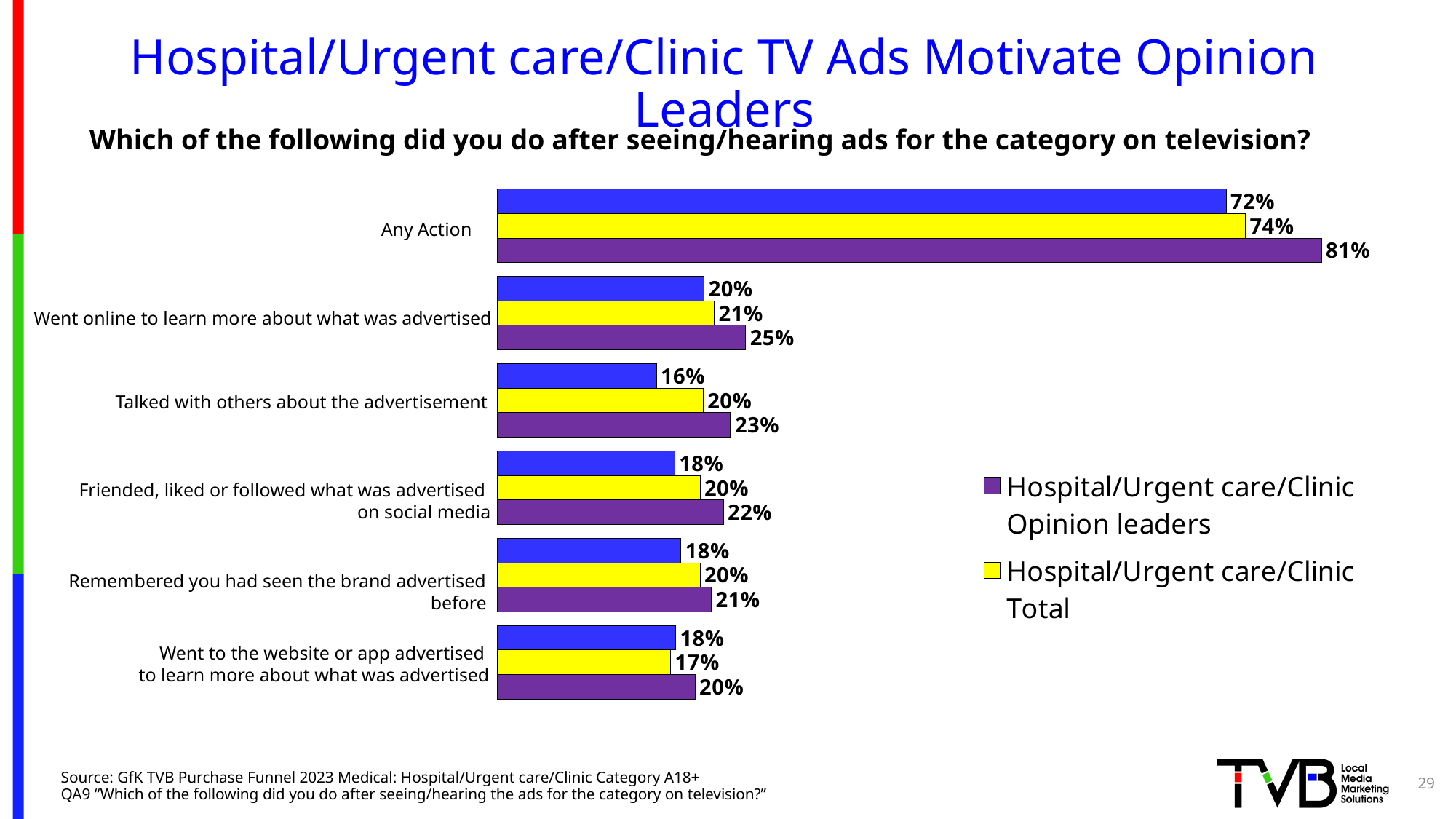
What percentage of Hospital/Urgent care/Clinic Opinion leaders talked with others about the advertisement? 23% What is the Hospital/Urgent care/Clinic Total value for 'Went to the website or app advertised to learn more about what was advertised'? 17% What colour represents Hospital/Urgent care/Clinic Total in the chart? Yellow What percentage of Hospital/Urgent care/Clinic Opinion leaders took Any Action after seeing/hearing ads on television? 81% How many action categories are shown on the chart? 6 What type of chart is shown on the slide? Bar chart Which category has the highest value for Hospital/Urgent care/Clinic Opinion leaders? Any Action Which category has the lowest value for Hospital/Urgent care/Clinic Total? Went to the website or app advertised to learn more about what was advertised What is the Hospital/Urgent care/Clinic Total value for 'Went online to learn more about what was advertised'? 21% For 'Talked with others about the advertisement', which is larger: the Opinion leaders value or the Total value? Opinion leaders How many series does the legend list? 2 What is the difference between the Opinion leaders and Total values for Any Action? 7%